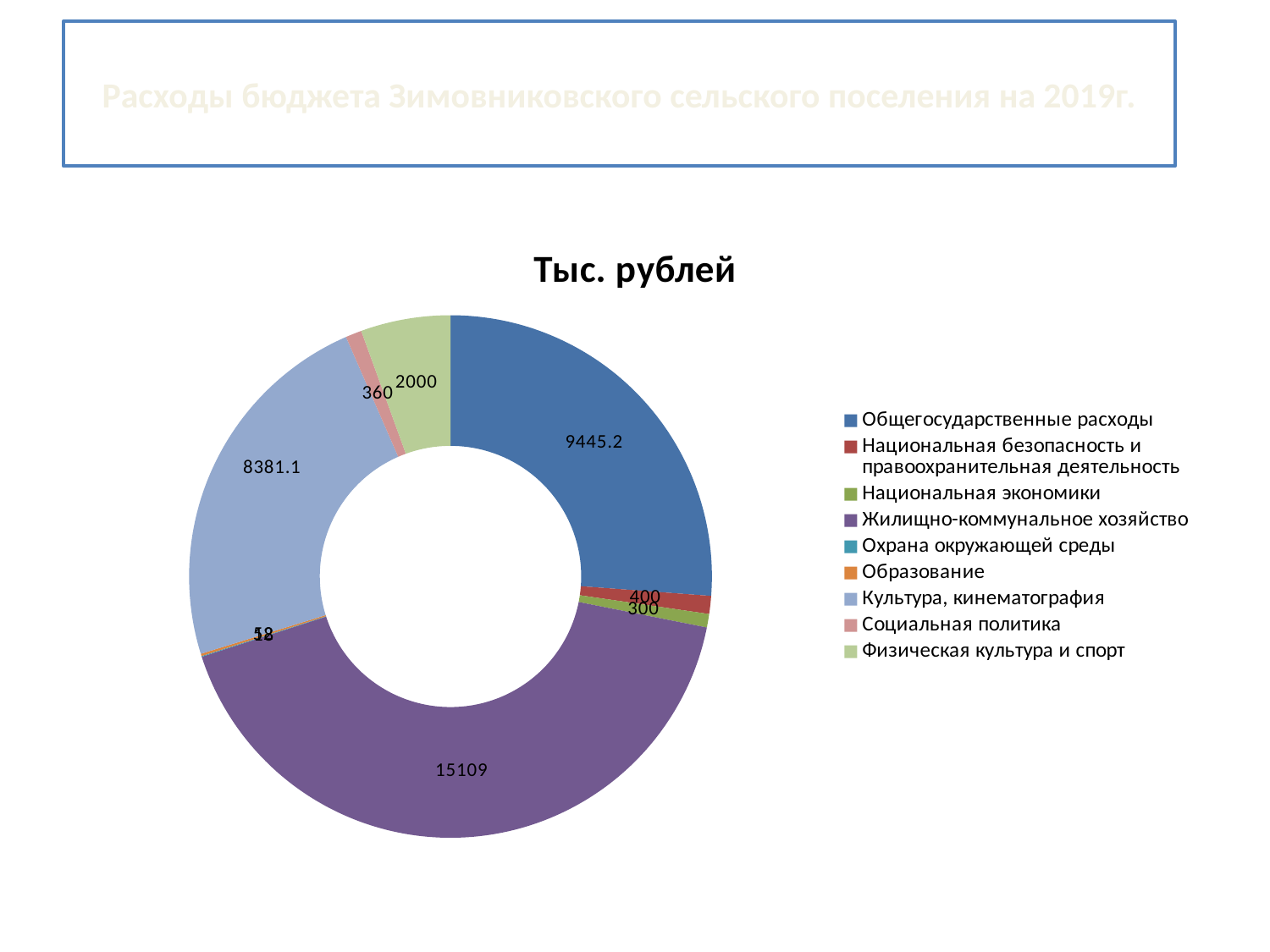
What is the title of the chart? Тыс. рублей What is the value for Общегосударственные расходы? 9445.2 What is the value for Социальная политика? 360 What is the value for Культура, кинематография? 8381.1 Which category has the largest value? Жилищно-коммунальное хозяйство What is the value for Национальная безопасность и правоохранительная деятельность? 400 What is the value for Физическая культура и спорт? 2000 What is the value for Жилищно-коммунальное хозяйство? 15109 How many categories does the chart's legend list? 9 What kind of chart is shown on the slide? Doughnut (pie) chart What is the difference between the values for Жилищно-коммунальное хозяйство and Общегосударственные расходы? 5663.8 Which is larger, the value for Культура, кинематография or the value for Общегосударственные расходы? Общегосударственные расходы